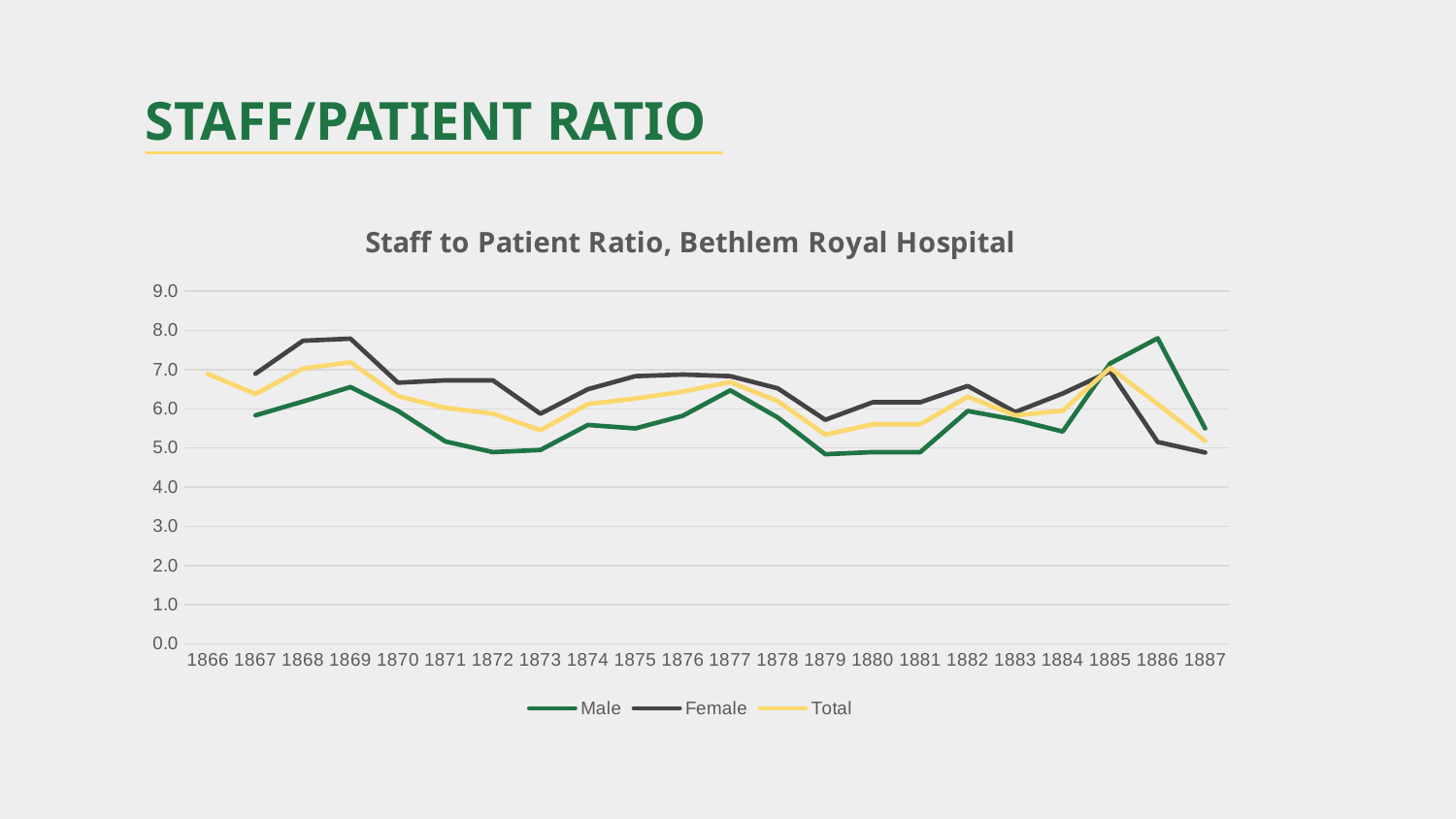
Is the Total value for 1866 greater or less than 6.0? greater In which year does the Female series reach its lowest value? 1887 How many series does the legend list? 3 In 1886, which series has the larger value, Male or Female? Male Is the Male value for 1886 greater or less than 7.0? greater How many years are labelled along the x axis? 22 In which year does the Male series reach its highest value? 1886 In 1869, which series has the larger value, Male or Female? Female Is the Female value for 1887 greater or less than 5.0? less Does the Male series rise or fall from 1886 to 1887? fall What kind of chart is shown on the slide? line chart What is the title of the chart? Staff to Patient Ratio, Bethlem Royal Hospital